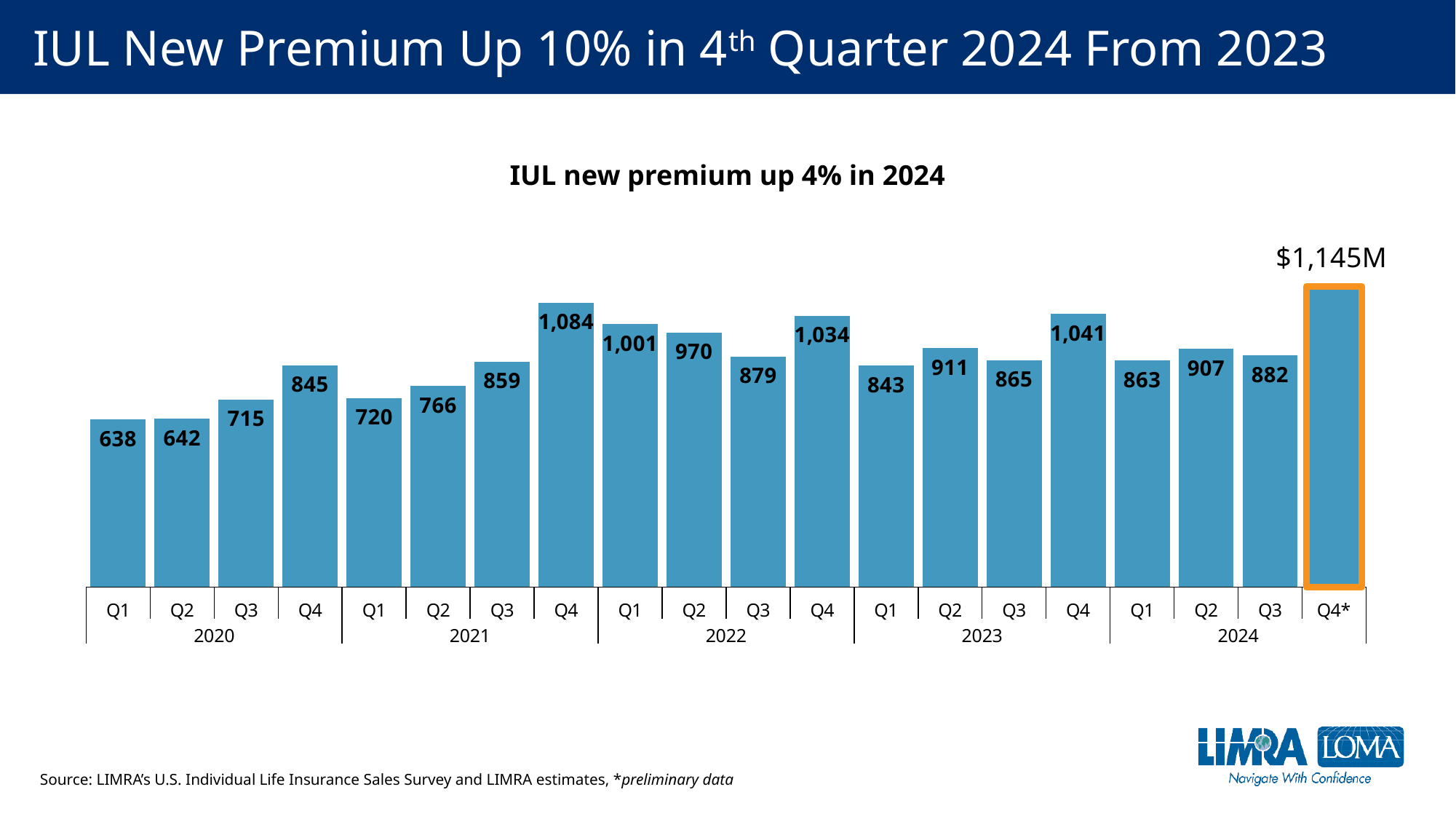
Do the values rise or fall from Q1 2020 to Q4 2020? Rise What is the value for Q1 2020? 638 How many bars are plotted on the chart? 20 Which quarter has the highest value? Q4* 2024 What is the difference between Q4 2023 and Q3 2023? 176 What is the value for Q4* 2024? $1,145M What kind of chart is shown? Bar chart What is the value for Q2 2023? 911 Which quarter has the lowest value? Q1 2020 What is the value for Q4 2021? 1,084 What is the title of the chart? IUL new premium up 4% in 2024 Which is larger, the value for Q1 2022 or the value for Q4 2022? Q4 2022